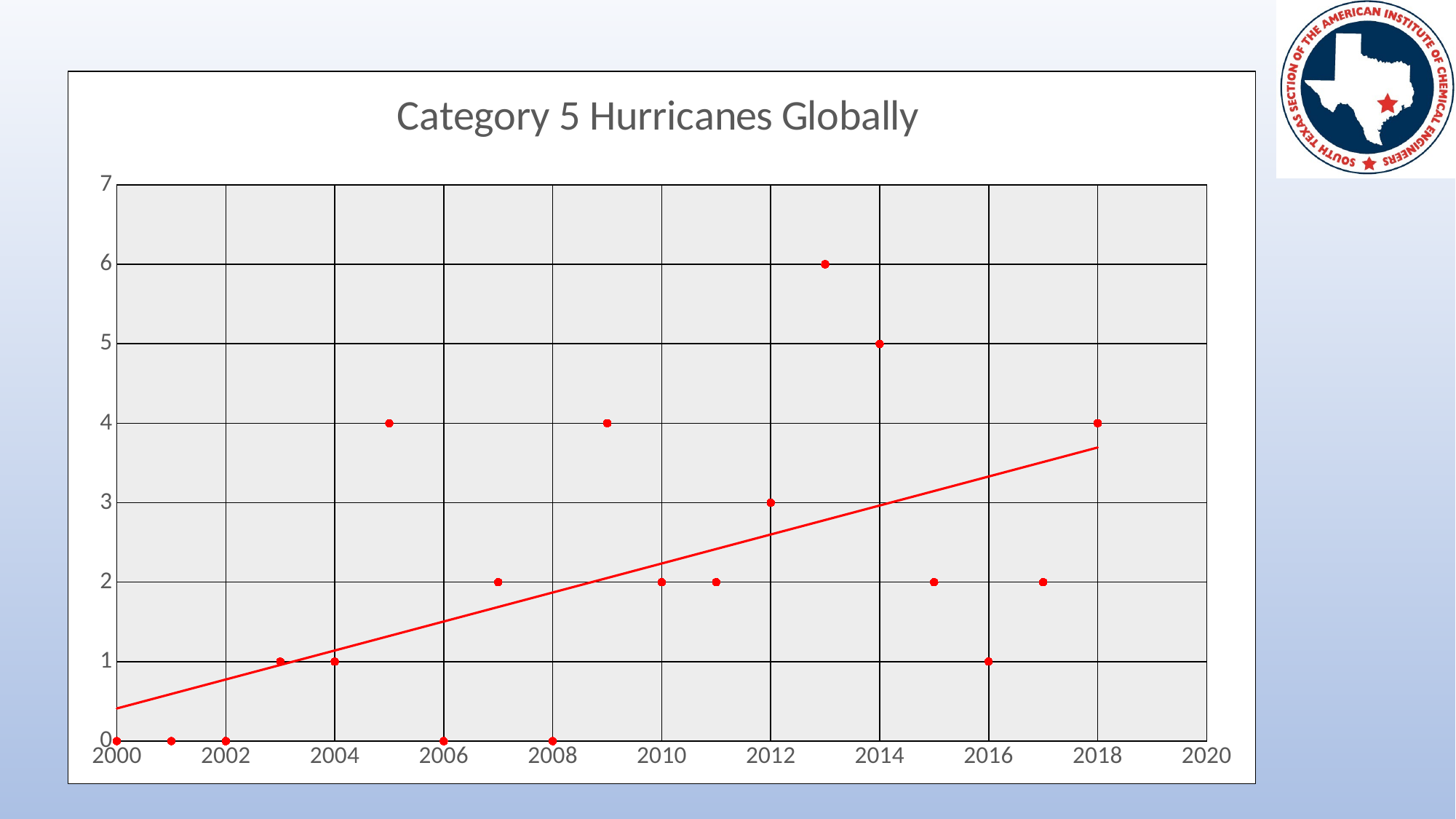
What is the title of the chart? Category 5 Hurricanes Globally What is the value plotted for 2016? 1 What is the value plotted for 2014? 5 Does the trend line rise or fall from 2000 to 2018? rise Which year has the highest plotted value? 2013 Which year has the larger value, 2005 or 2012? 2005 What type of chart is shown on the slide? scatter chart What is the lowest value plotted on the chart? 0 What is the value plotted for 2005? 4 What is the value plotted for 2012? 3 What is the value plotted for 2013? 6 What is the difference between the values for 2013 and 2014? 1